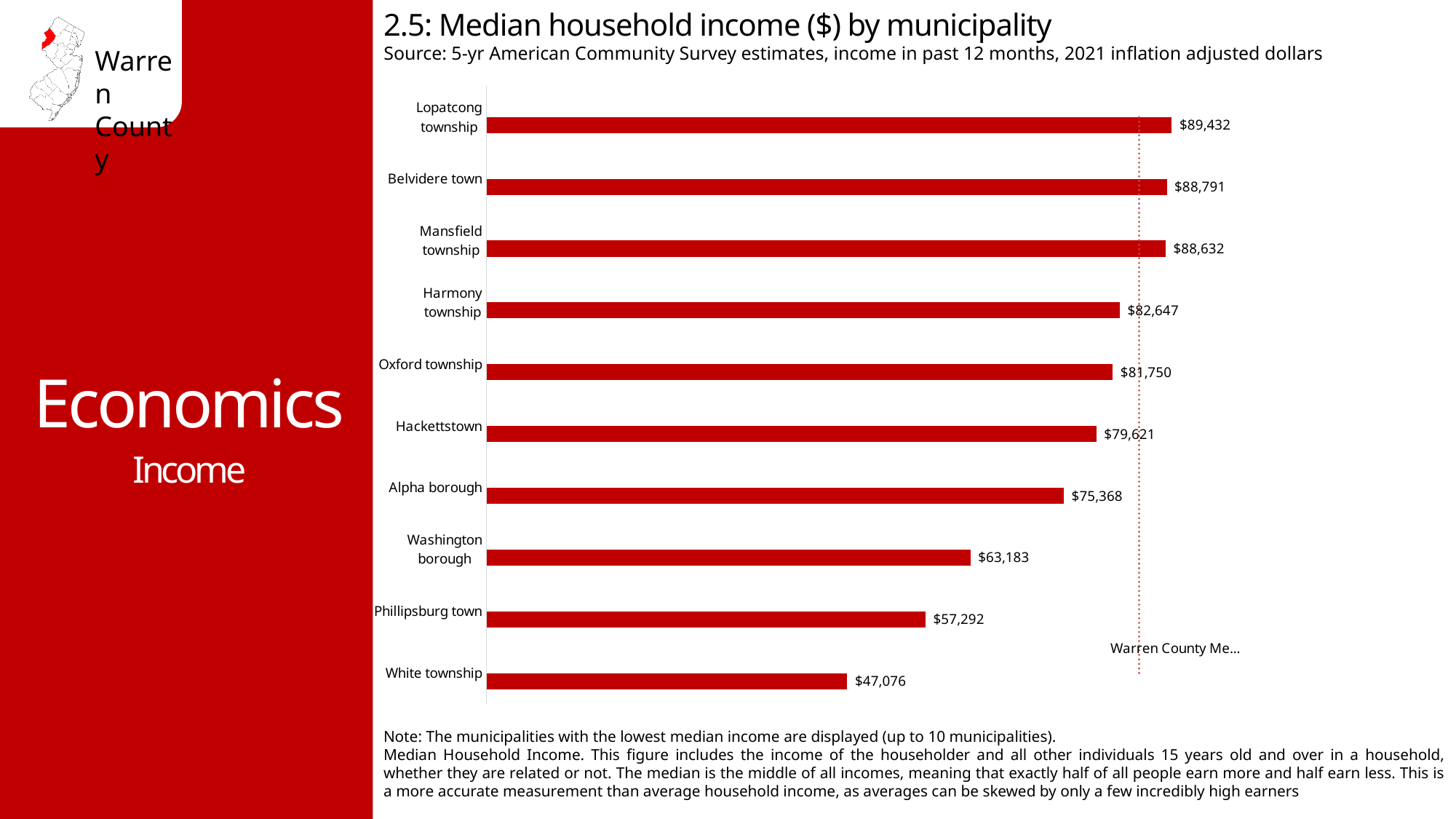
What is the median household income for Lopatcong township? $89,432 Which has a higher median household income, Oxford township or Washington borough? Oxford township What is the median household income for Hackettstown? $79,621 What is the difference in median household income between Alpha borough and Phillipsburg town? $18,076 What is the difference in median household income between Lopatcong township and White township? $42,356 How many municipalities are shown on the chart? 10 Which municipality has the lowest median household income shown on the chart? White township Which municipality has the highest median household income shown on the chart? Lopatcong township What kind of chart is used to show median household income by municipality? Bar chart What is the median household income for Washington borough? $63,183 What is the median household income for White township? $47,076 What is the title of the chart? 2.5: Median household income ($) by municipality